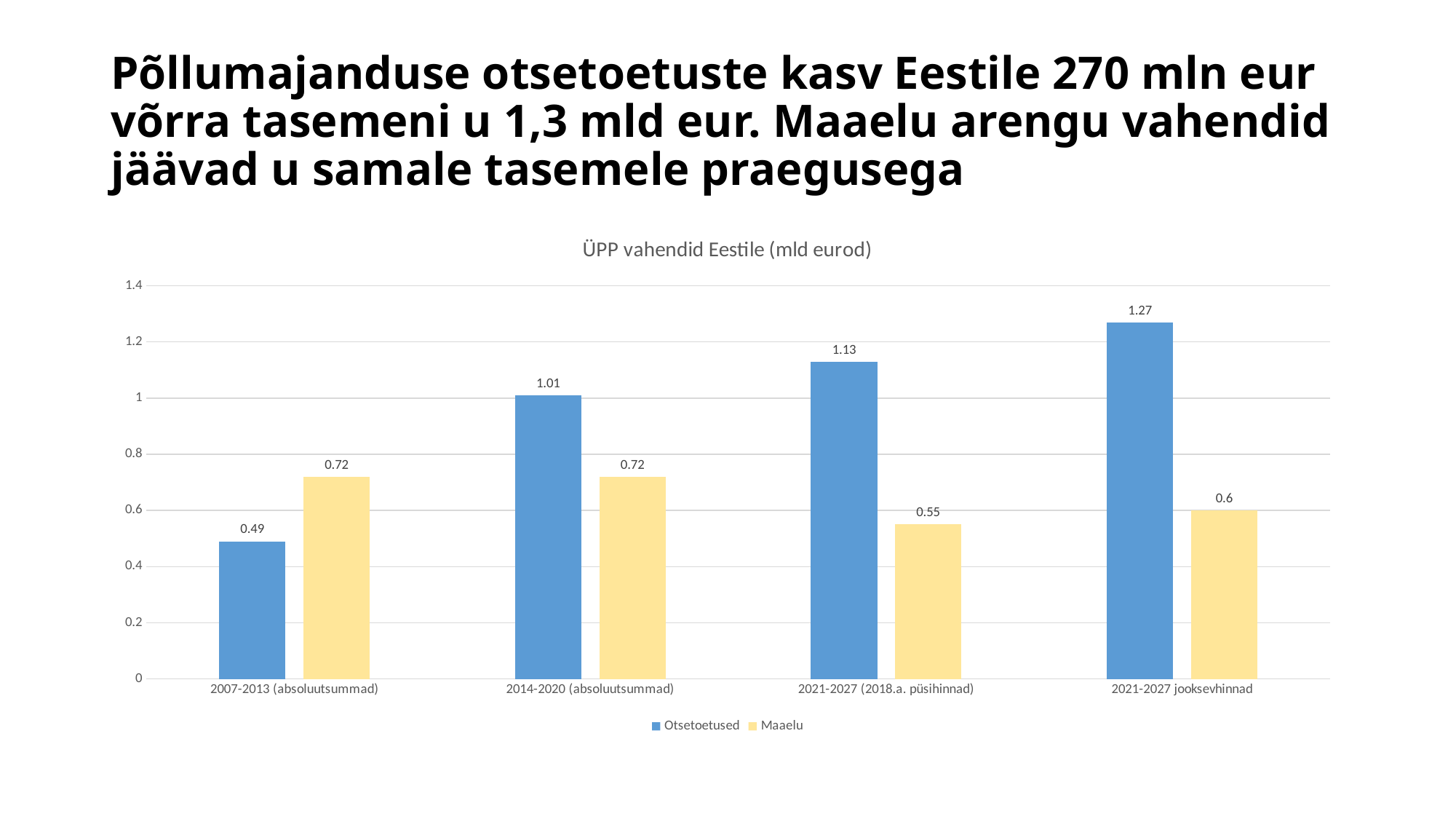
What is the value of Otsetoetused for 2021-2027 jooksevhinnad? 1.27 How many categories are shown on the x axis? 4 For 2007-2013 (absoluutsummad), which is larger: Otsetoetused or Maaelu? Maaelu What is the title of the chart? ÜPP vahendid Eestile (mld eurod) Which category has the highest Otsetoetused value? 2021-2027 jooksevhinnad What kind of chart is shown on the slide? Bar chart What is the difference between Otsetoetused and Maaelu for 2014-2020 (absoluutsummad)? 0.29 What is the value of Maaelu for 2021-2027 (2018.a. püsihinnad)? 0.55 What is the value of Otsetoetused for 2007-2013 (absoluutsummad)? 0.49 Which category has the lowest Maaelu value? 2021-2027 (2018.a. püsihinnad) Do the Otsetoetused values rise or fall from left to right across the categories? Rise How many series does the legend list? 2